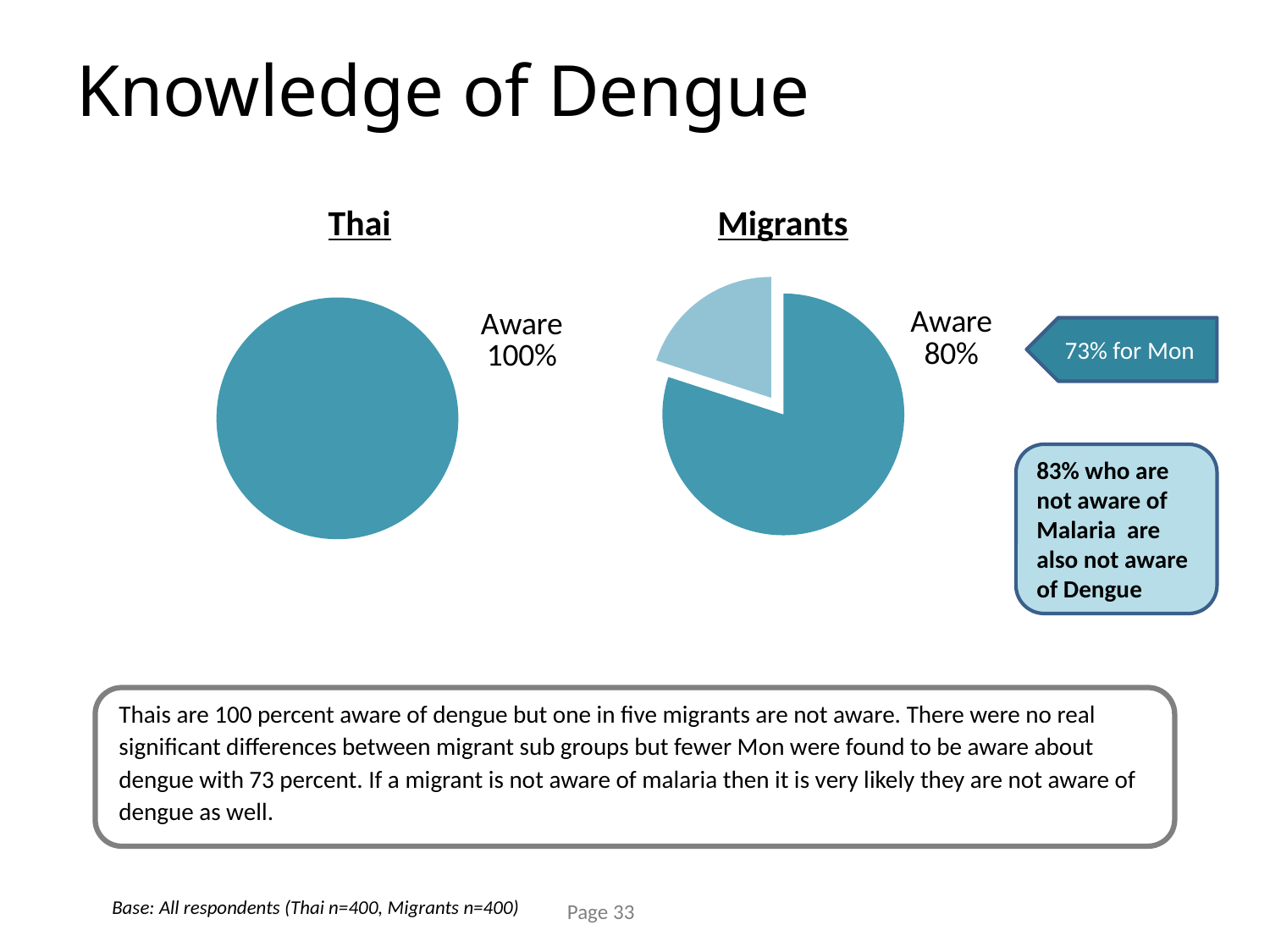
Is the Aware value in the Migrants pie chart greater or less than 50%? greater How many slices does the Thai pie chart have? 1 What is the difference in dengue awareness between the Thai and Migrants pie charts? 20 percentage points What share of the Migrants pie does the Aware slice represent? 80% Which group has the higher awareness of dengue, Thai or Migrants? Thai How many slices does the Migrants pie chart have? 2 What kind of chart is used for the Thai data? pie chart In the Migrants pie chart, what percentage are aware of dengue? 80% According to the callout next to the Migrants pie chart, what is the awareness figure for Mon? 73% What is the title of the slide containing the two pie charts? Knowledge of Dengue In the Thai pie chart, what percentage are aware of dengue? 100%